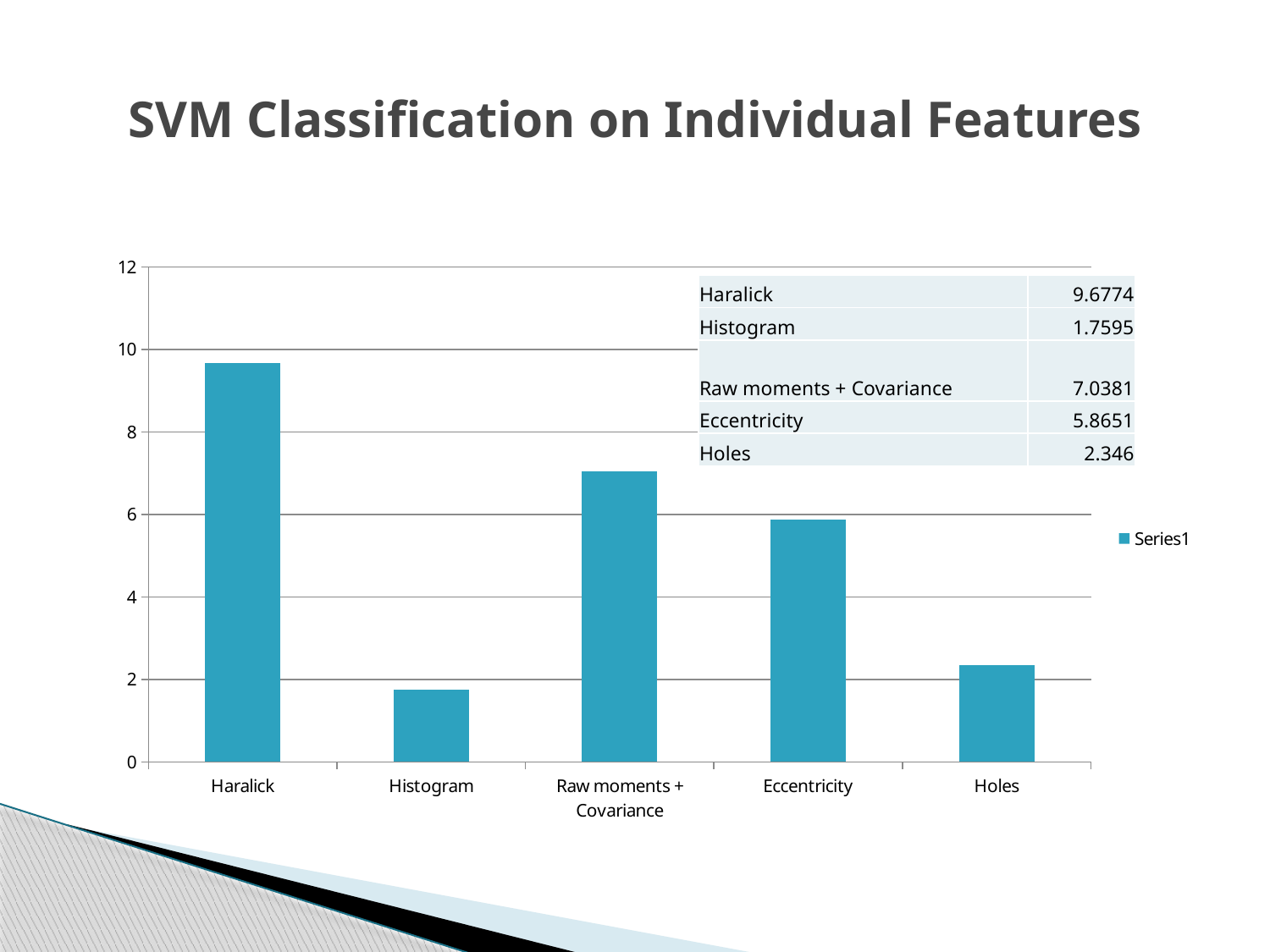
What is the value for Histogram? 1.7595 How many categories are shown on the x axis? 5 Which category has the lowest value? Histogram What kind of chart is shown on the slide? Bar chart What is the value for Haralick? 9.6774 Which is larger, the value for Eccentricity or the value for Holes? Eccentricity What is the title of the slide containing the chart? SVM Classification on Individual Features What is the difference between the values for Raw moments + Covariance and Eccentricity? 1.173 What is the value for Holes? 2.346 What is the value for Raw moments + Covariance? 7.0381 Which category has the highest value? Haralick What is the difference between the values for Haralick and Histogram? 7.9179